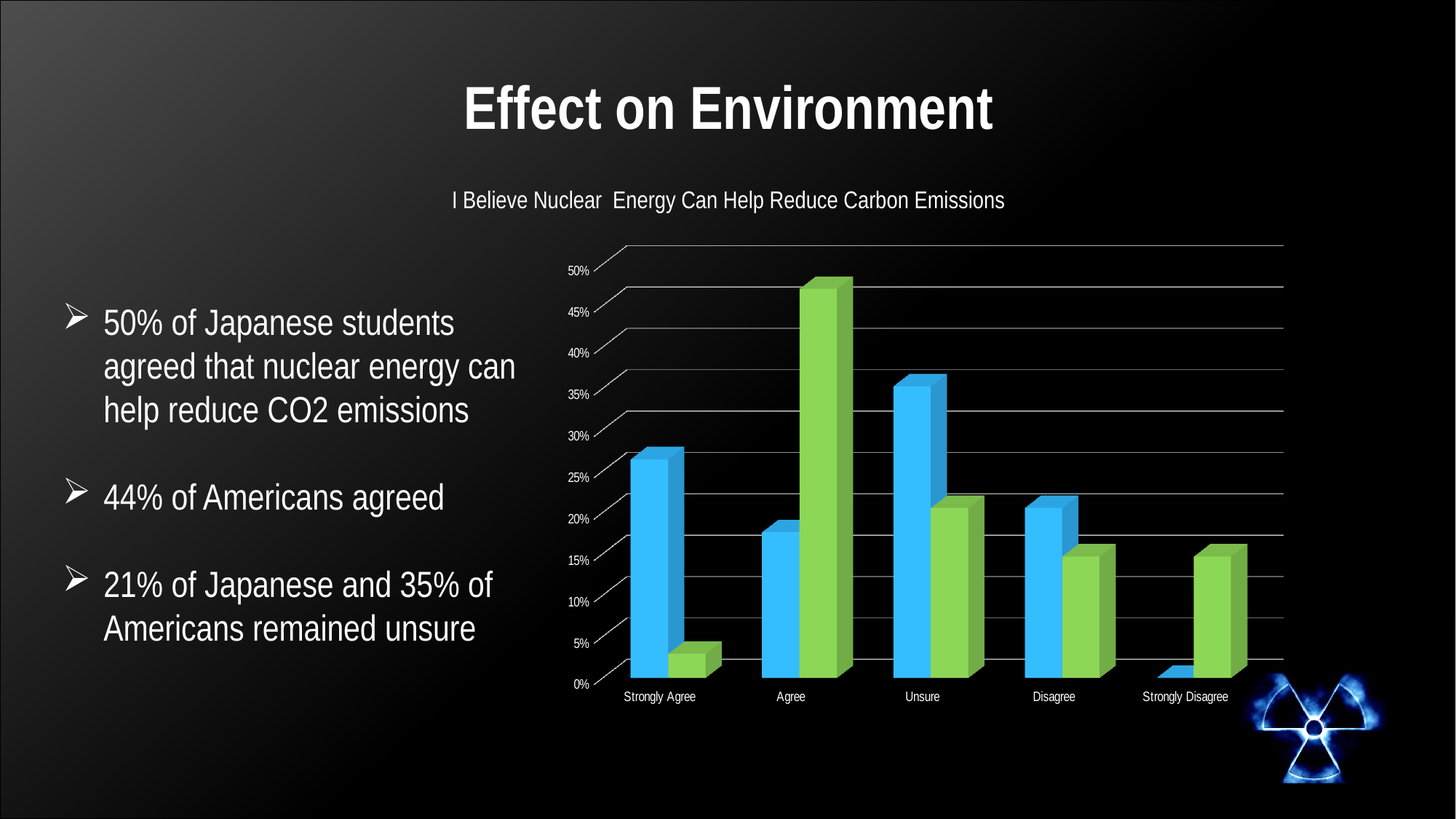
For the Strongly Agree category, which bar is taller, the blue one or the green one? Blue Is the blue bar for Strongly Agree greater or less than 30%? less Which category has the tallest green bar? Agree Which category has the shortest green bar? Strongly Agree Which category has the shortest blue bar? Strongly Disagree For the Agree category, which bar is taller, the blue one or the green one? Green Is the blue bar for Unsure greater or less than 30%? greater How many categories are shown on the x axis of the chart? 5 What is the title of the chart? I Believe Nuclear Energy Can Help Reduce Carbon Emissions What kind of chart is shown on the slide? Bar chart Which category has the tallest blue bar? Unsure Is the green bar for Agree greater or less than 40%? greater